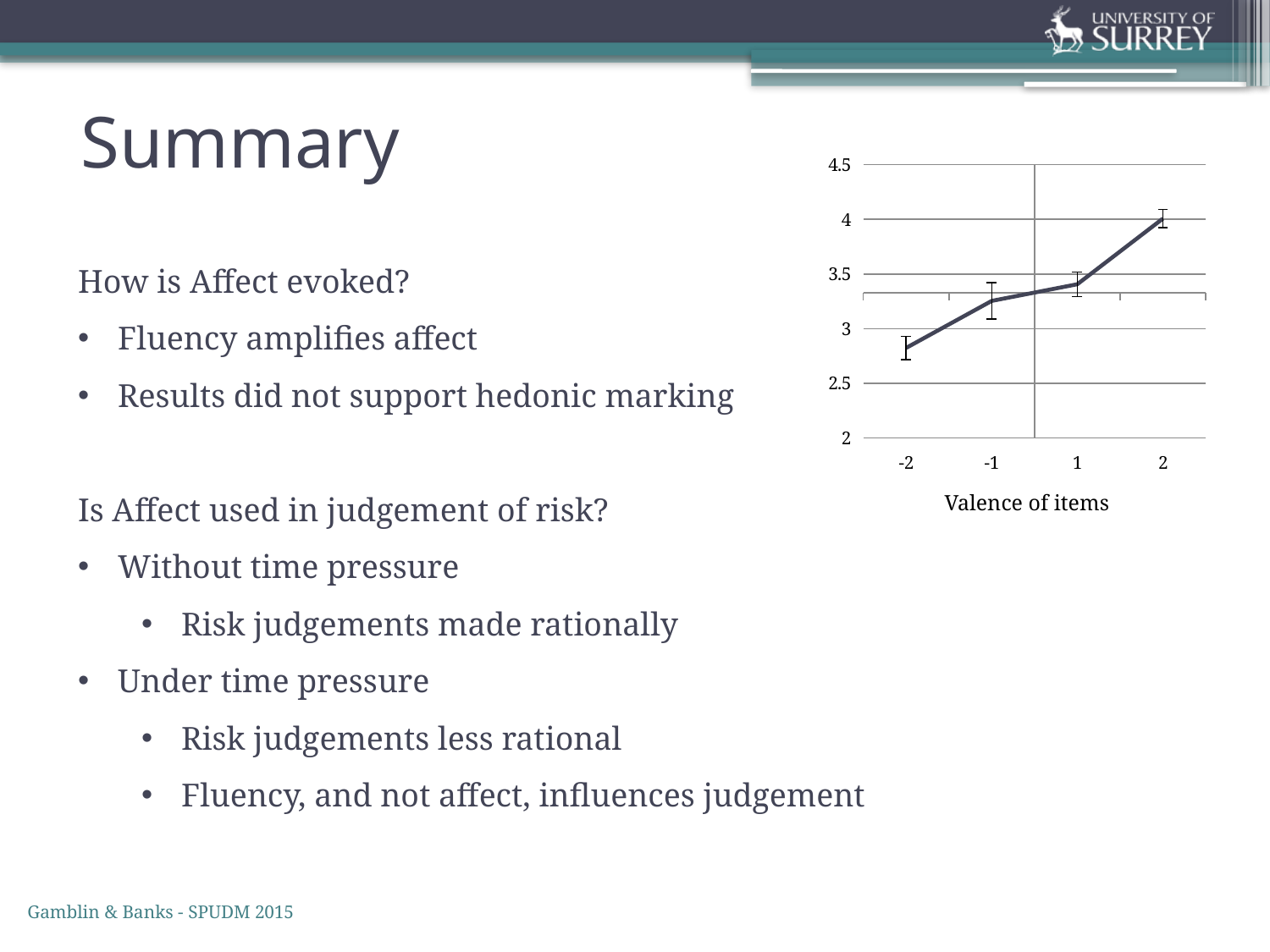
Which has the larger value, valence 2 or valence -2? 2 Is the value for valence 1 greater or less than 3? greater Which valence of items has the highest value? 2 Is the value for valence -2 greater or less than 3? less Which valence of items has the lowest value? -2 How many points are plotted on the line chart? 4 Do the values rise or fall as valence of items increases from -2 to 2? rise What kind of chart is shown on the slide? line chart Is the value for valence 2 greater or less than 3.5? greater What is the title of the x axis of the chart? Valence of items Which has the larger value, valence -2 or valence 1? 1